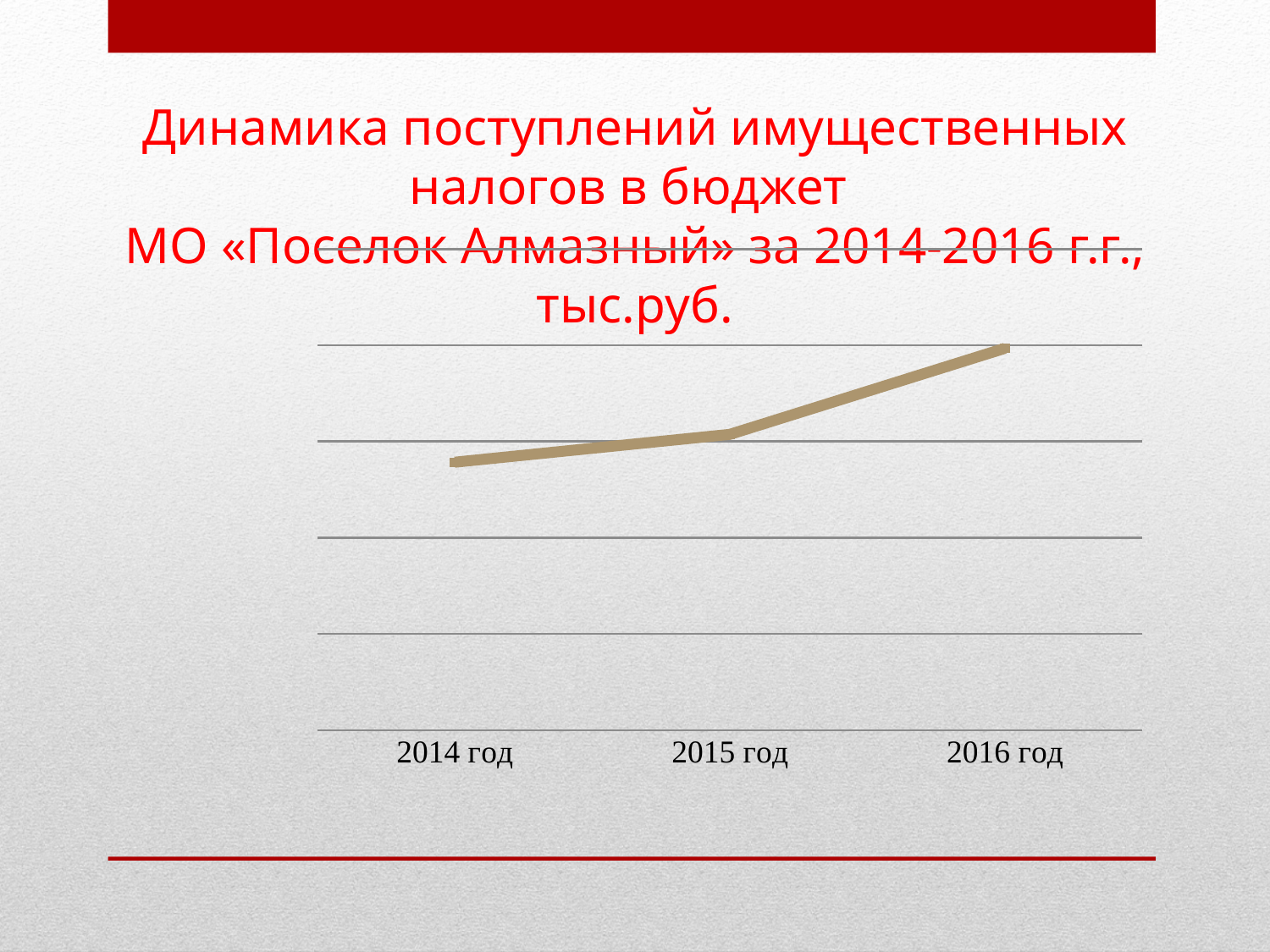
Between which two consecutive years does the line rise most steeply? 2015 год and 2016 год What is the first year label on the x axis of the chart? 2014 год Which year has the highest value in the chart? 2016 год How many years are plotted along the x axis of the chart? 3 In what units are the values in the chart expressed, according to the slide title? тыс.руб. What kind of chart is shown on the slide? line chart Which is larger, the value for 2016 год or the value for 2014 год? 2016 год Which is larger, the value for 2015 год or the value for 2016 год? 2016 год Which year has the lowest value in the chart? 2014 год Do the values in the chart rise or fall from 2014 год to 2016 год? rise